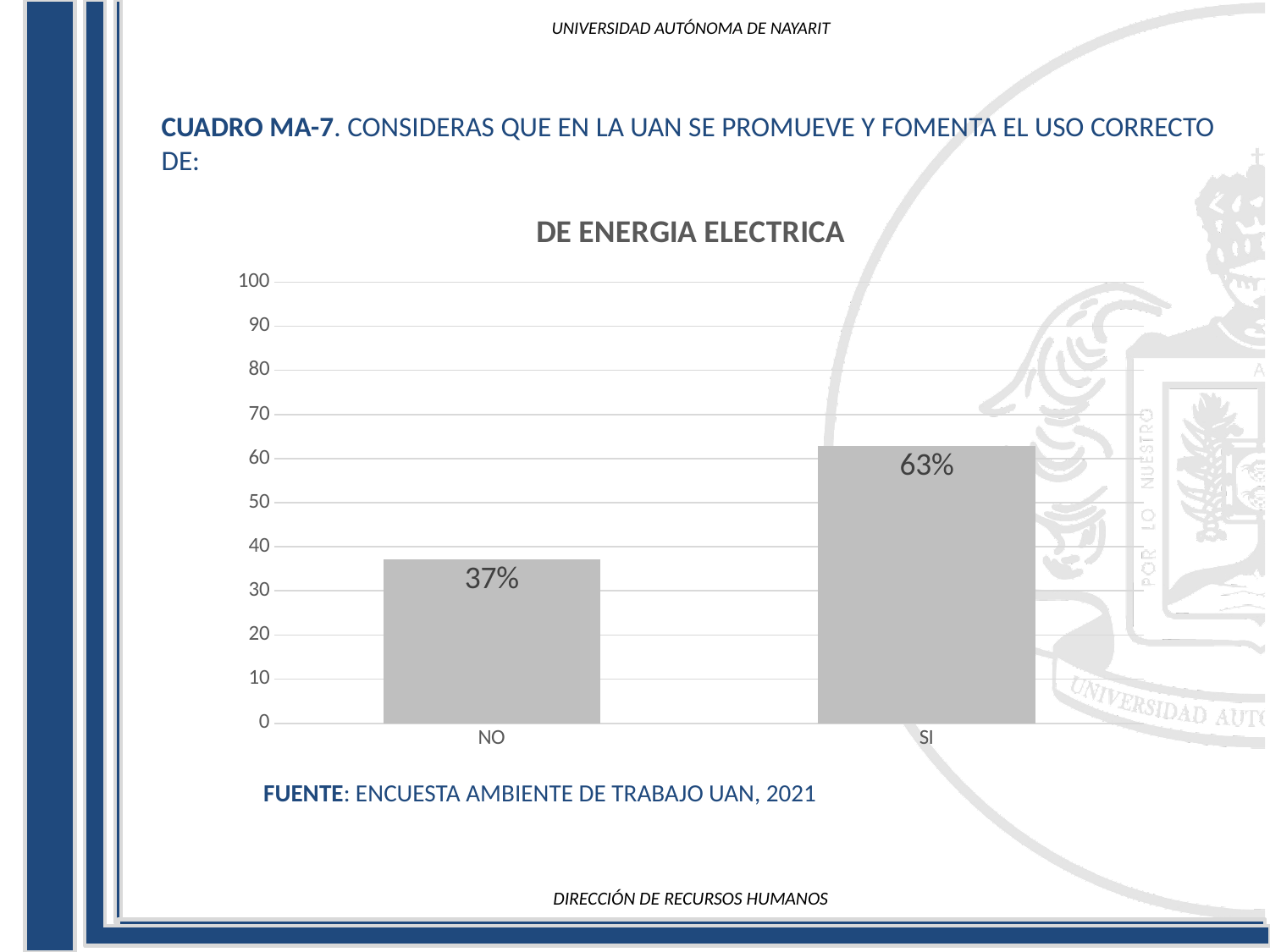
Which is larger, the value for NO or the value for SI? SI How many categories are shown on the x axis? 2 What is the value for NO? 37% Is the value for SI greater or less than 60? greater Is the value for NO greater or less than 40? less Which category has the lowest value? NO Which category has the highest value? SI What is the value for SI? 63% What is the difference between the values for SI and NO? 26% What is the title of the chart? DE ENERGIA ELECTRICA What kind of chart is shown on the slide? bar chart What is the highest value shown on the y axis? 100